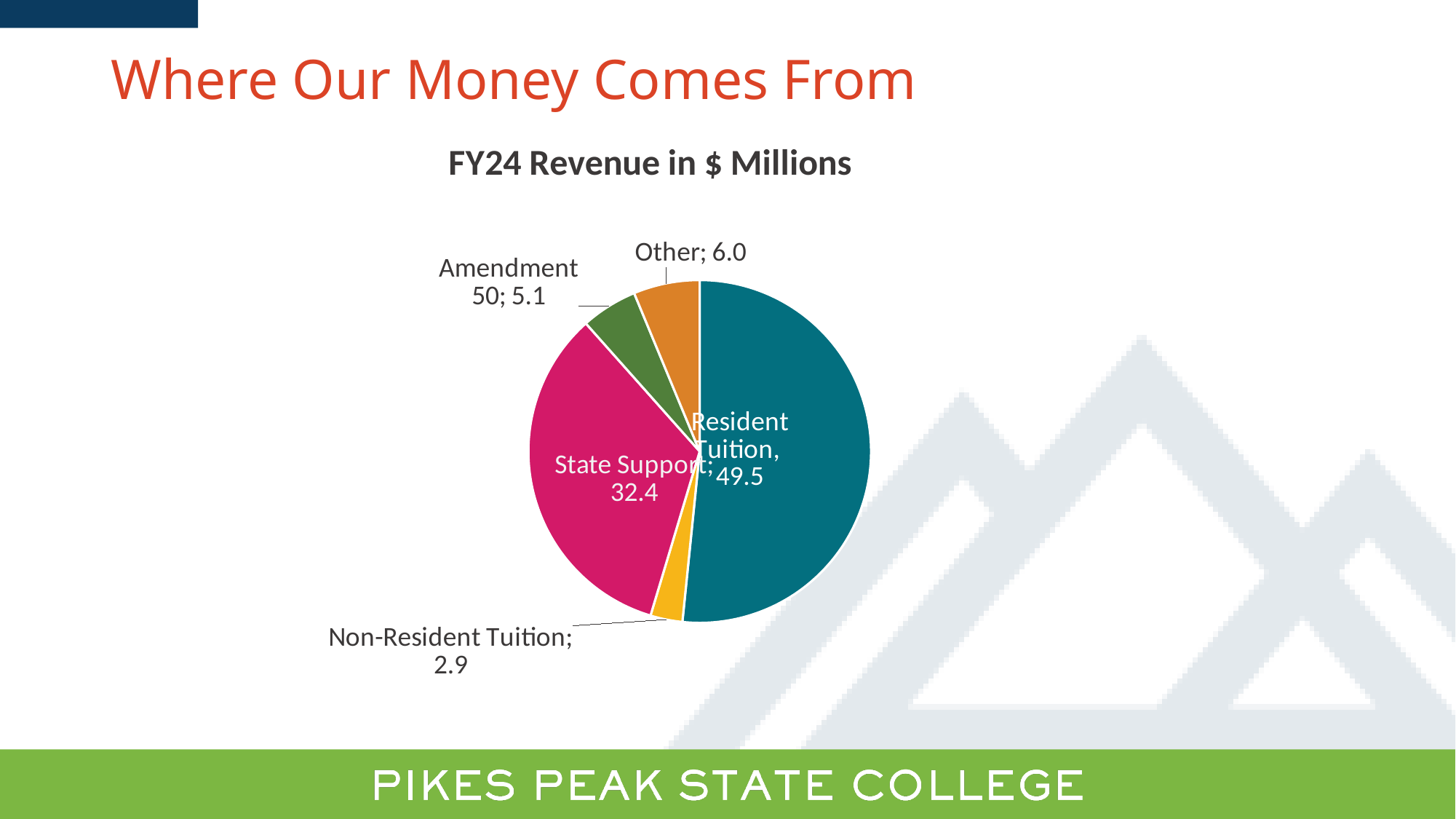
What is the value for Resident Tuition? 49.5 What is the value for Amendment 50? 5.1 What is the value for State Support? 32.4 Which revenue source has the largest slice? Resident Tuition Which revenue source has the smallest slice? Non-Resident Tuition What type of chart is shown on the slide? Pie chart What is the total of all the slices in the pie chart? 95.9 How many slices does the pie chart have? 5 What is the value for Non-Resident Tuition? 2.9 Which is larger, Other or Amendment 50? Other What is the difference between Resident Tuition and State Support? 17.1 What is the title of the chart? FY24 Revenue in $ Millions